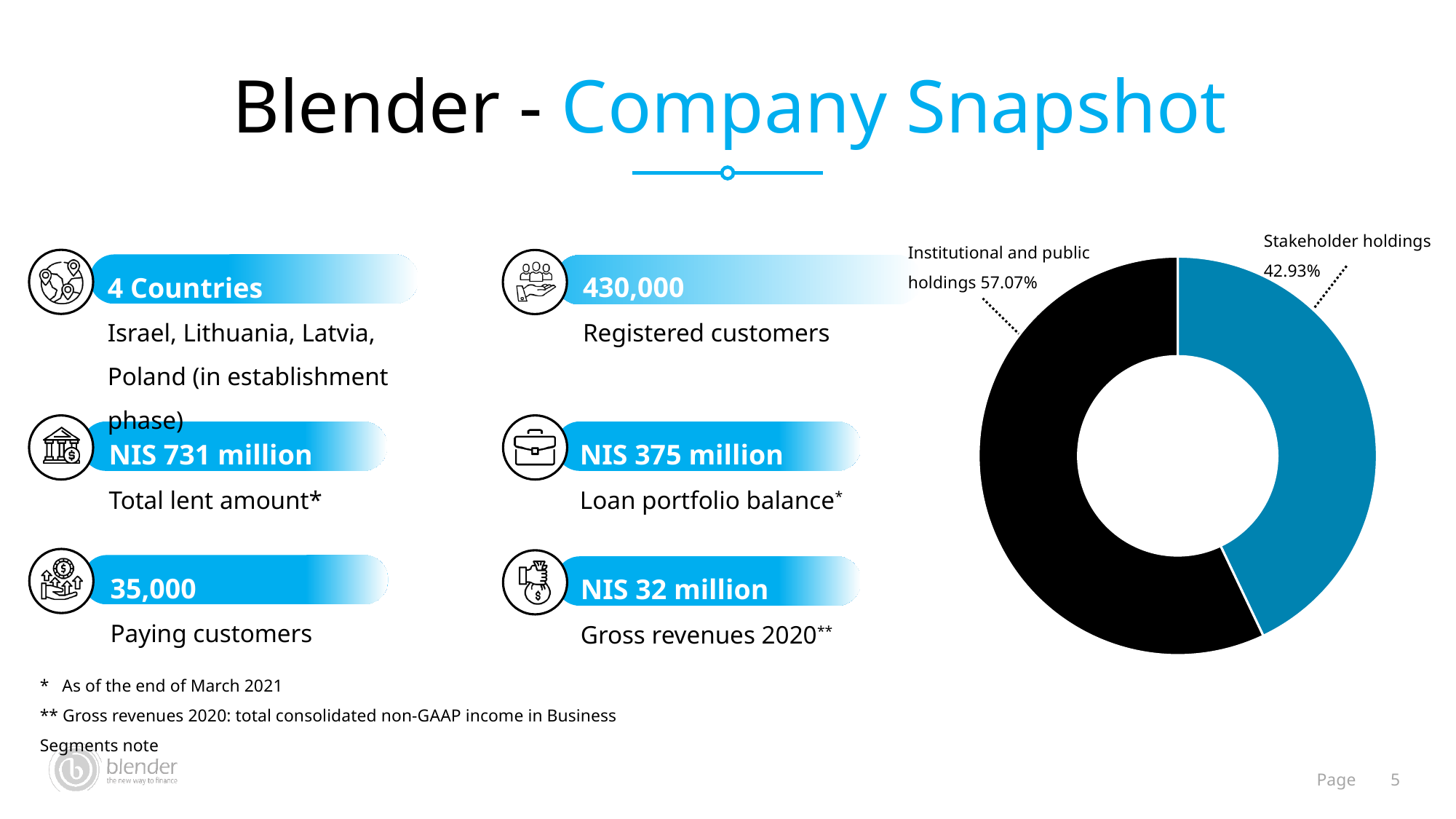
What kind of chart is shown on the slide? Doughnut chart What is the value for Stakeholder holdings? 42.93% Which slice is the largest? Institutional and public holdings How many slices does the doughnut chart have? 2 Which is larger, Stakeholder holdings or Institutional and public holdings? Institutional and public holdings Which slice is the smallest? Stakeholder holdings What colour is the Institutional and public holdings slice? Black What is the value for Institutional and public holdings? 57.07% Is the value for Stakeholder holdings greater or less than 50%? less What colour is the Stakeholder holdings slice? Blue What is the difference between Institutional and public holdings and Stakeholder holdings? 14.14%